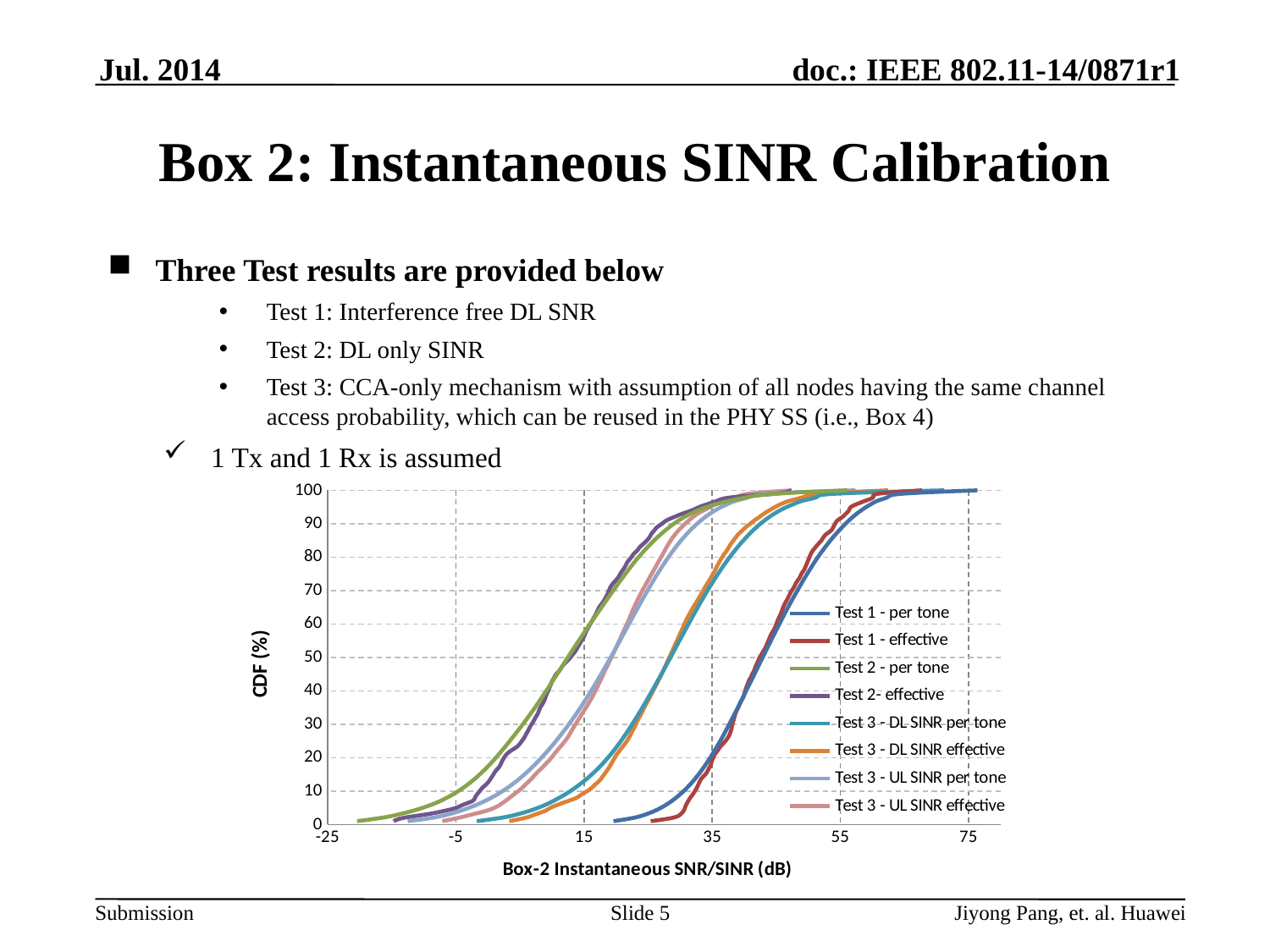
How many series does the chart legend list? 8 Is the value of the Test 1 - per tone curve at 35 dB greater or less than 50? less Is the value of the Test 2 - per tone curve at -5 dB greater or less than 50? less Do the CDF curves rise or fall as the SNR/SINR increases along the x axis? rise Is the value of the Test 3 - DL SINR per tone curve at 35 dB greater or less than 50? greater At 55 dB, which curve has the higher CDF value: Test 2 - per tone or Test 1 - per tone? Test 2 - per tone What is the highest value shown on the y axis? 100 What kind of chart is shown on the slide? line chart How many tick labels are shown on the x axis? 6 What is the y-axis title of the chart? CDF (%) What is the x-axis title of the chart? Box-2 Instantaneous SNR/SINR (dB)